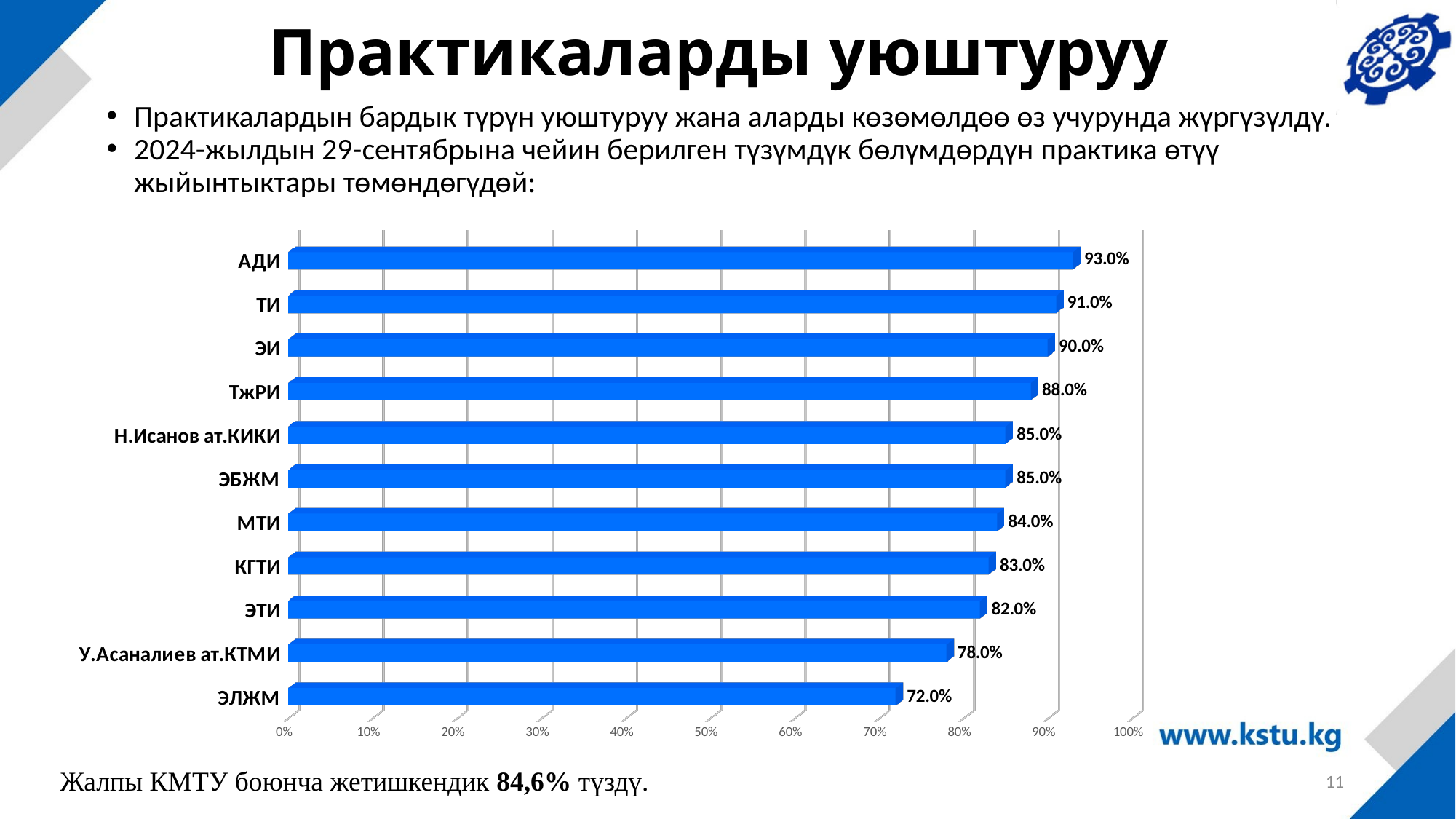
What is the difference between the values for АДИ and ЭЛЖМ? 21.0% What is the value for ЭЛЖМ? 72.0% What kind of chart is shown on the slide? bar chart What is the value for ТжРИ? 88.0% Which category has the lowest value? ЭЛЖМ What is the value for У.Асаналиев ат.КТМИ? 78.0% Is the value for ЭЛЖМ greater or less than 80%? less Which category has the highest value? АДИ What is the difference between the values for ТИ and ЭТИ? 9.0% What is the value for АДИ? 93.0% How many categories are shown in the chart? 11 Which is larger, the value for МТИ or the value for КГТИ? МТИ